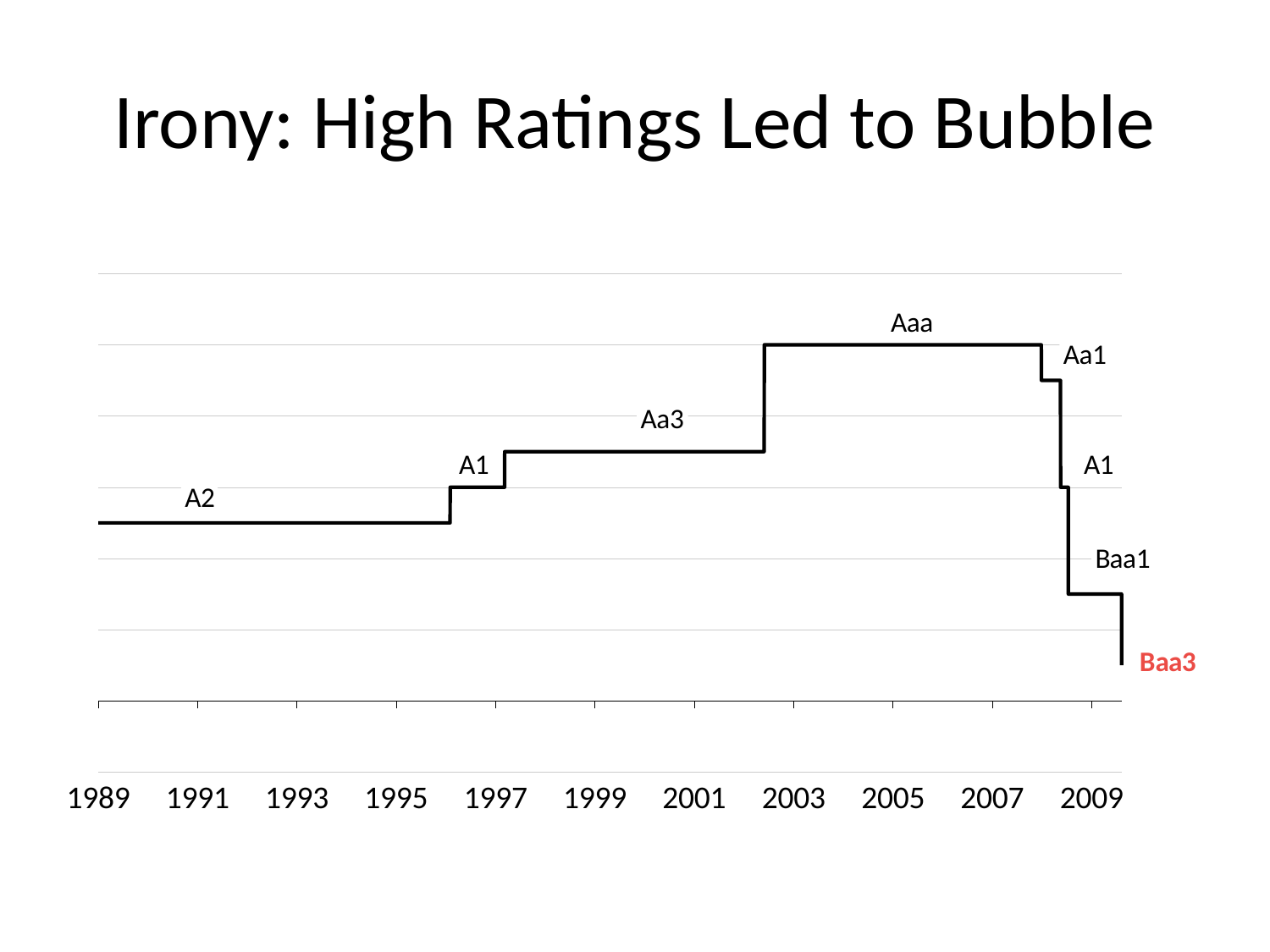
What kind of chart is shown on the slide? line chart What is the highest rating label reached by the line? Aaa What rating label is shown for the start of the series in 1989? A2 Which rating label is printed in red on the chart? Baa3 How many year labels are shown on the x axis? 11 Does the rating rise or fall between 1989 and 2005? rise What rating label is shown for 1999? Aa3 Does the rating rise or fall between 2007 and 2009? fall What is the final rating label at the end of the line in 2009? Baa3 What is the lowest rating label shown on the line? Baa3 What rating label is shown for 2005? Aaa What is the title of the chart on the slide? Irony: High Ratings Led to Bubble